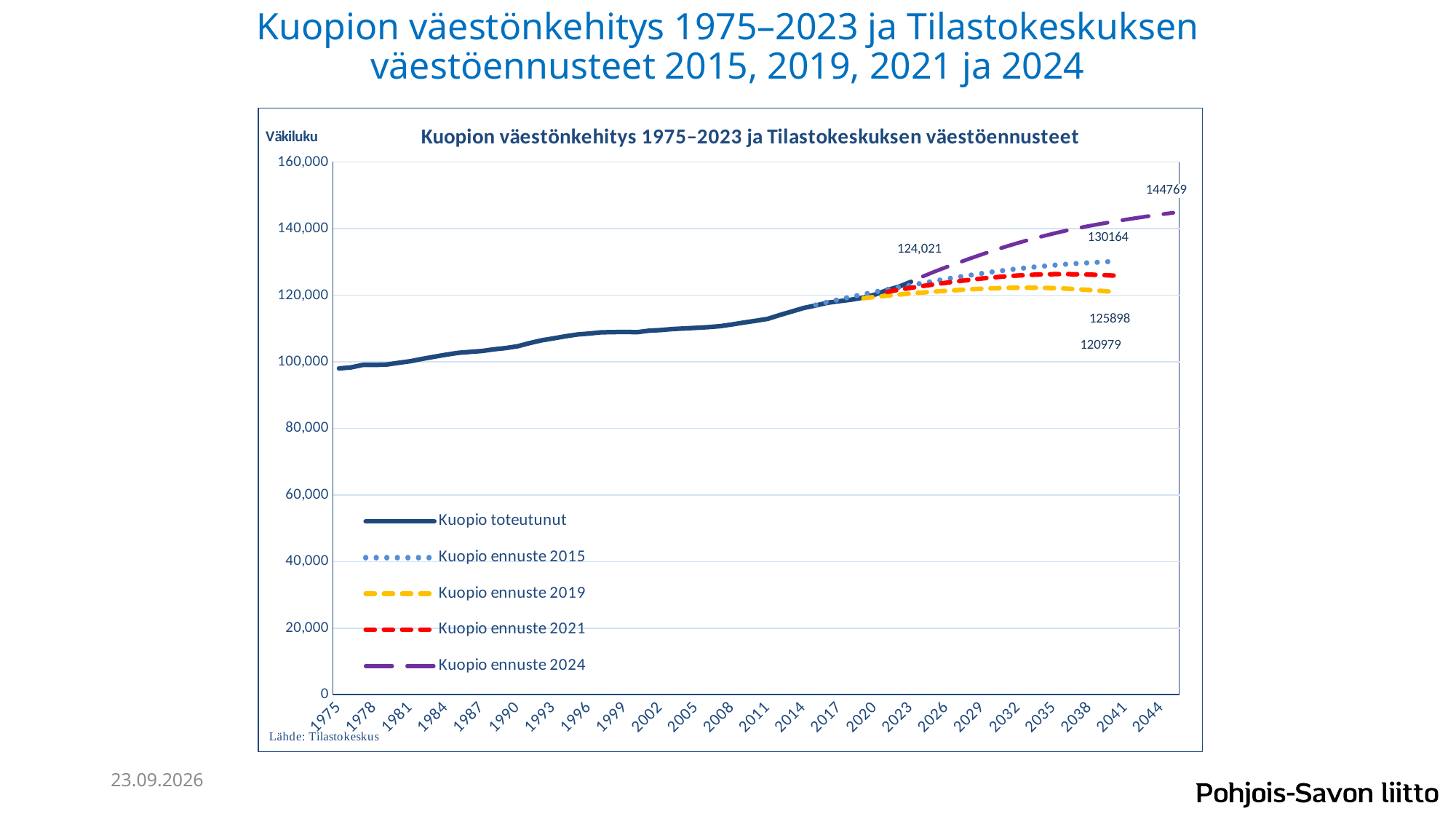
Which forecast series ends at the lowest value? Kuopio ennuste 2019 What kind of chart is shown on the slide? line chart What is the labelled value of the Kuopio toteutunut series at its last point (2023)? 124,021 Does the Kuopio toteutunut series rise or fall from 1975 to 2023? rise What is the final labelled value of the Kuopio ennuste 2019 series? 120979 Which forecast series ends at the highest value? Kuopio ennuste 2024 How many series does the legend list? 5 Is the value of Kuopio toteutunut in 1975 greater or less than 100,000? less What is the difference between the end values of Kuopio ennuste 2024 (144769) and Kuopio ennuste 2019 (120979)? 23790 What is the final labelled value of the Kuopio ennuste 2015 series? 130164 What is the final labelled value of the Kuopio ennuste 2024 series? 144769 What is the final labelled value of the Kuopio ennuste 2021 series? 125898